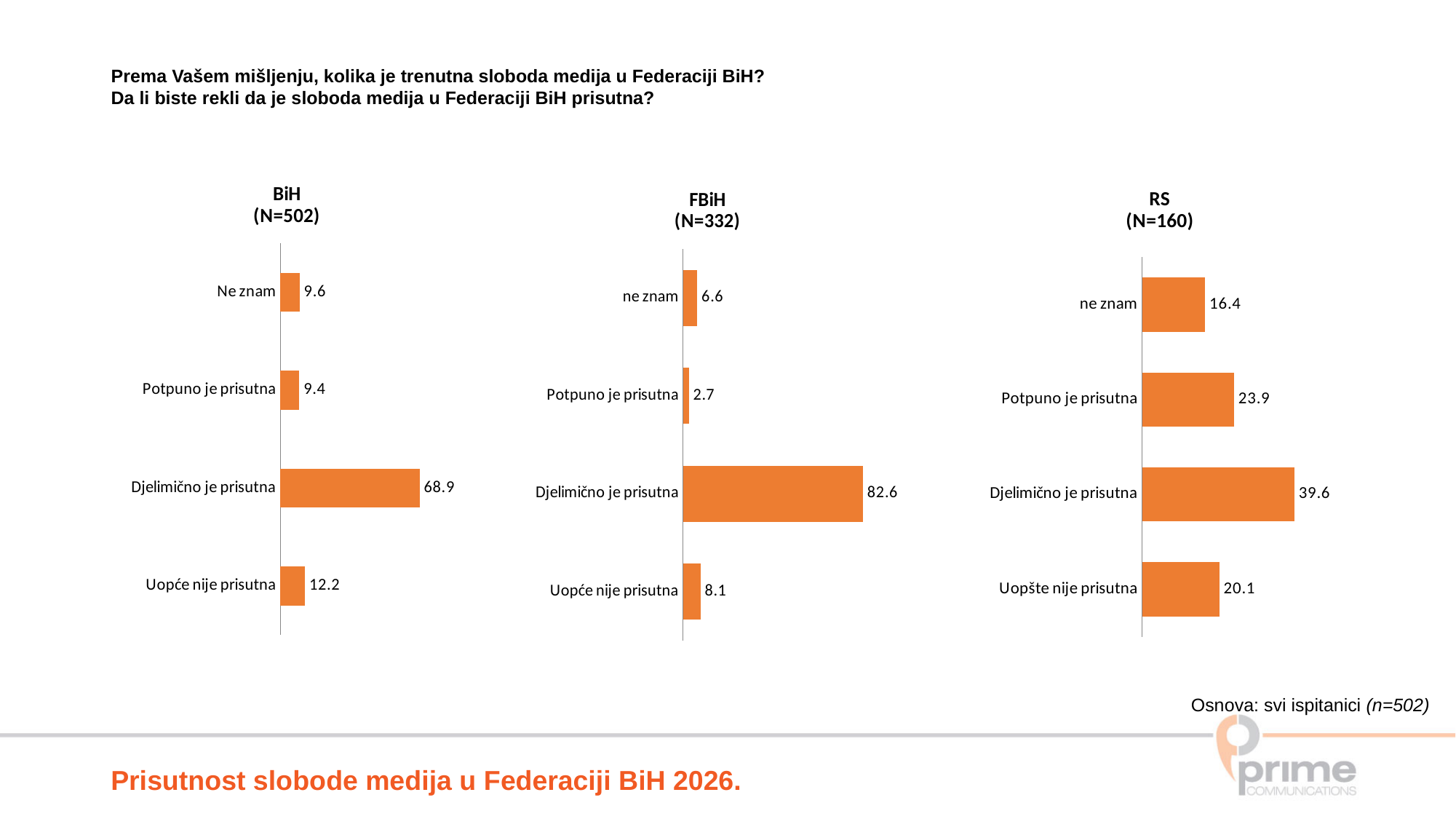
In the FBiH (N=332) chart, which is larger: "Uopće nije prisutna" or "ne znam"? Uopće nije prisutna In the FBiH (N=332) chart, which category has the lowest value? Potpuno je prisutna How many charts are shown on the slide? 3 How many categories are shown in the RS (N=160) chart? 4 In the RS (N=160) chart, what is the difference between "Potpuno je prisutna" and "Uopšte nije prisutna"? 3.8 What kind of chart is the BiH (N=502) chart? Bar chart In the BiH (N=502) chart, what is the difference between "Djelimično je prisutna" and "Uopće nije prisutna"? 56.7 Which chart shows the higher value for "Djelimično je prisutna": BiH (N=502) or FBiH (N=332)? FBiH (N=332) In the RS (N=160) chart, what is the value for "ne znam"? 16.4 In the RS (N=160) chart, which category has the highest value? Djelimično je prisutna In the BiH (N=502) chart, what is the value for "Djelimično je prisutna"? 68.9 In the FBiH (N=332) chart, what is the value for "Potpuno je prisutna"? 2.7